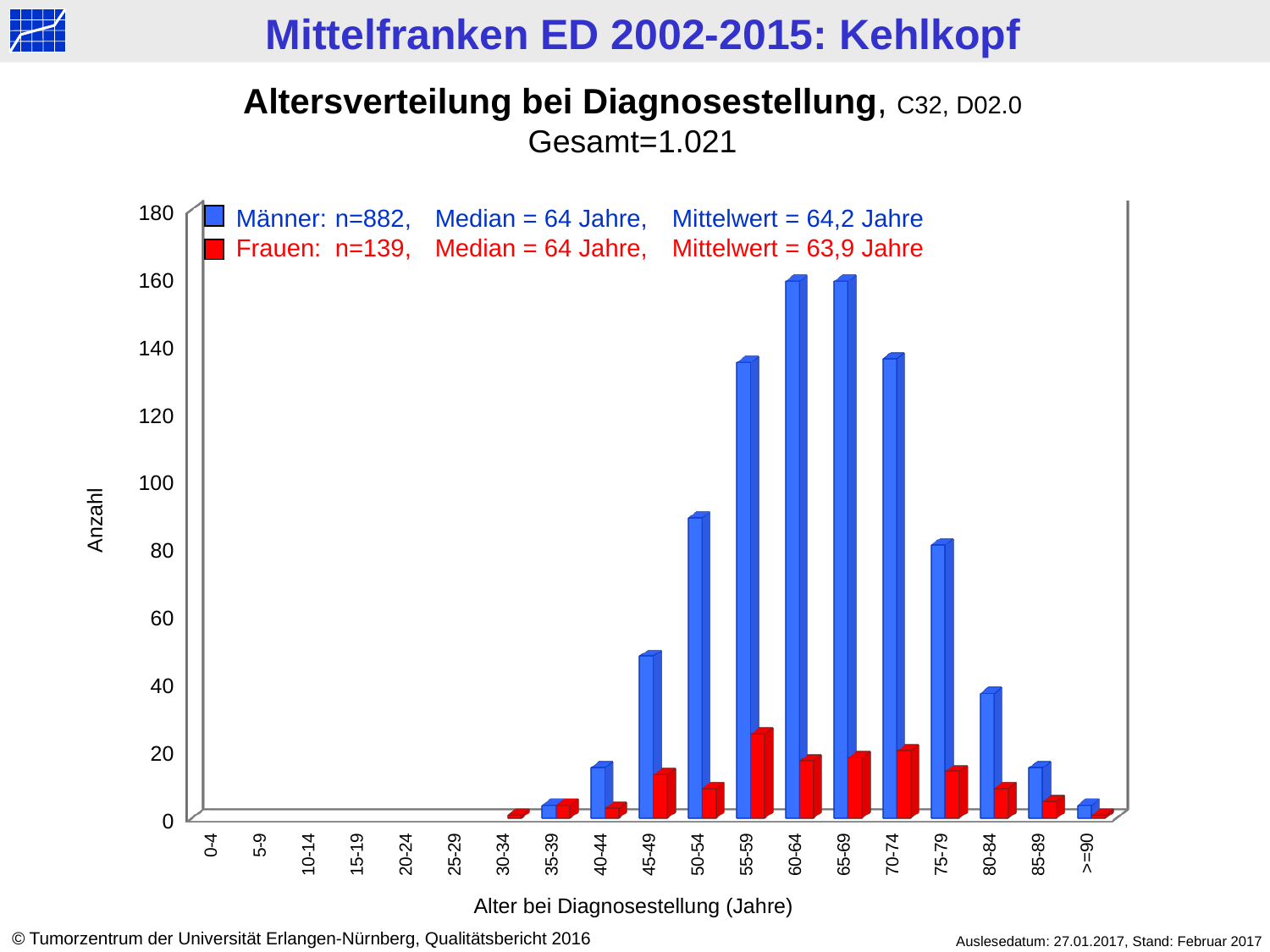
According to the legend, what is the Mittelwert for Frauen? 63,9 Jahre Is the value for Männer in the 60-64 age group greater or less than 140? greater How many series does the legend list? 2 Is the value for Frauen in the 55-59 age group greater or less than 40? less Is the value for Männer in the 50-54 age group greater or less than 100? less How many age groups are shown along the x axis? 19 In which age group is the Frauen value highest? 55-59 What kind of chart is shown on the slide? bar chart Which is larger for Männer: the value for 50-54 or the value for 75-79? 50-54 Which is larger in the 45-49 age group: Männer or Frauen? Männer According to the legend, what is n for Männer? 882